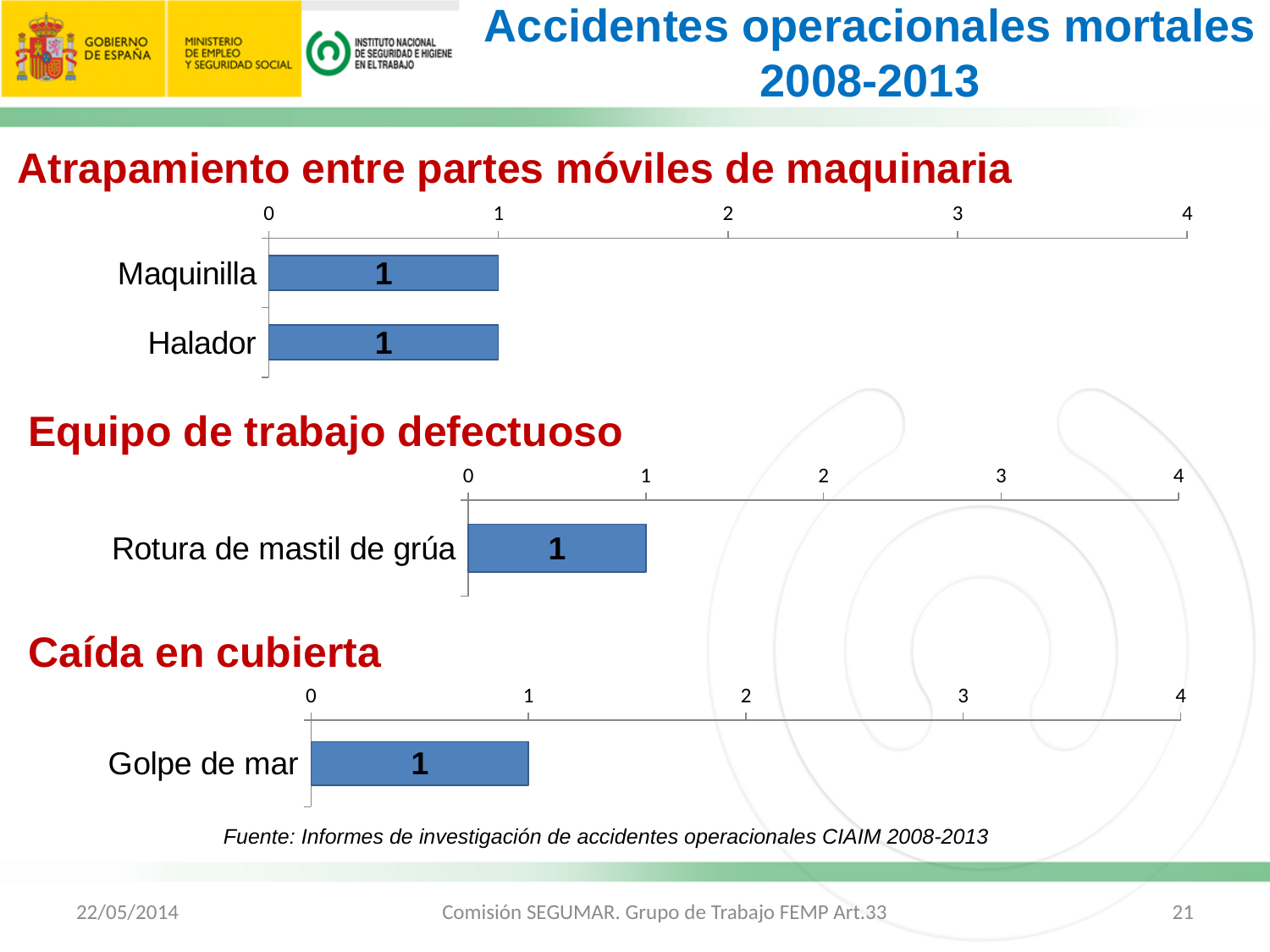
In the 'Atrapamiento entre partes móviles de maquinaria' chart, what is the total of the values for Maquinilla and Halador? 2 In the 'Atrapamiento entre partes móviles de maquinaria' chart, what is the value for Halador? 1 In the 'Equipo de trabajo defectuoso' chart, how many categories are shown? 1 What kind of chart is the 'Caída en cubierta' chart? bar chart In the 'Atrapamiento entre partes móviles de maquinaria' chart, how many categories are shown? 2 In the 'Caída en cubierta' chart, what is the value for Golpe de mar? 1 In the 'Atrapamiento entre partes móviles de maquinaria' chart, what is the value for Maquinilla? 1 In the 'Atrapamiento entre partes móviles de maquinaria' chart, what is the difference between the values for Maquinilla and Halador? 0 In the 'Equipo de trabajo defectuoso' chart, what is the value for Rotura de mastil de grúa? 1 In the 'Equipo de trabajo defectuoso' chart, what is the highest value shown on the x axis? 4 In the 'Caída en cubierta' chart, is the value for Golpe de mar greater or less than 2? less How many charts are shown on the slide? 3